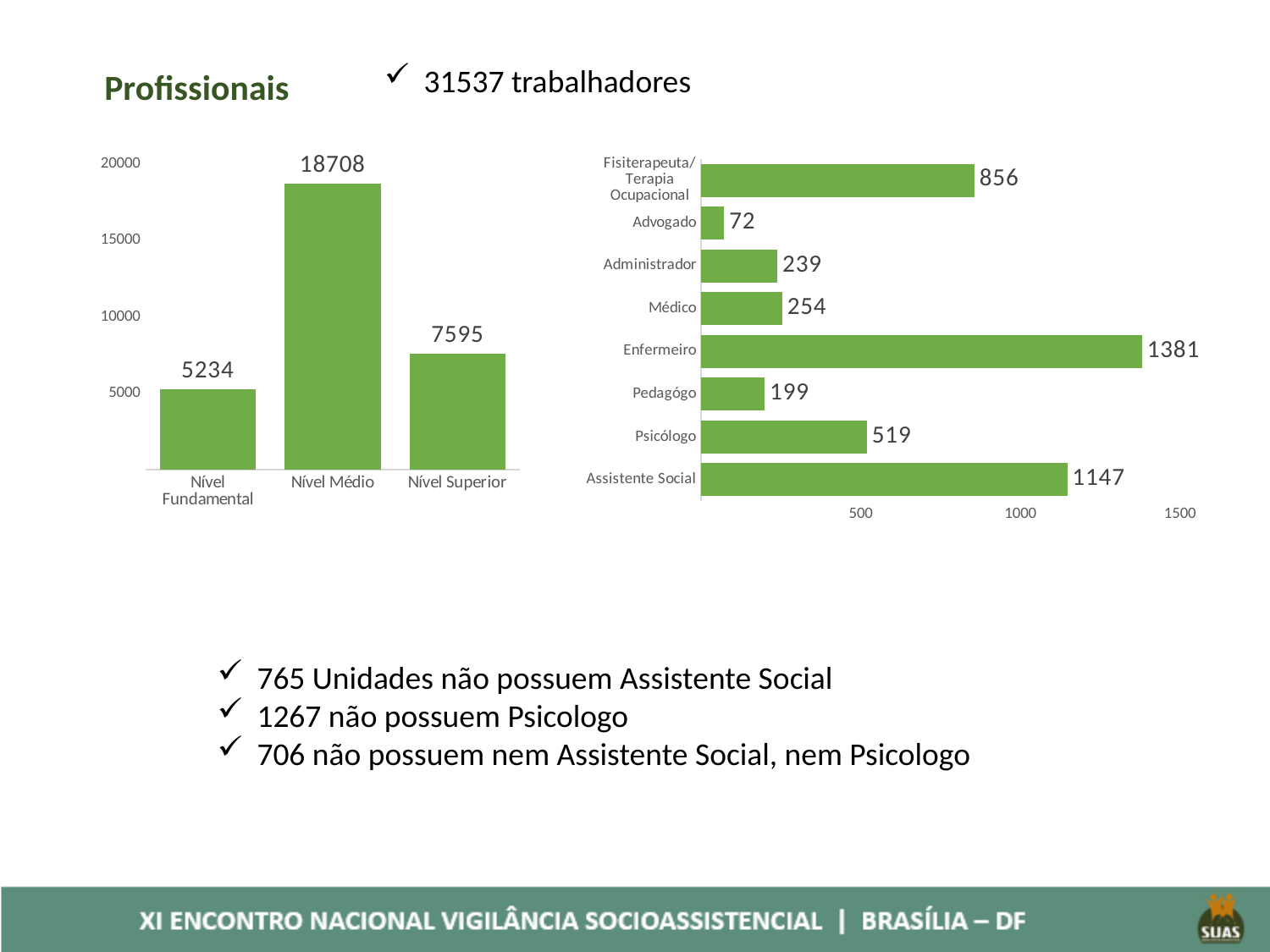
In the right chart, which is larger, Médico or Administrador? Médico In the left chart, how many categories are shown? 3 In the right chart, is the value for Fisiterapeuta/Terapia Ocupacional greater or less than 1000? less In the right chart, what is the value for Psicólogo? 519 In the right chart, what is the difference between Enfermeiro and Assistente Social? 234 In the right chart, which category has the highest value? Enfermeiro What kind of chart is the chart on the right? Bar chart In the left chart, which category has the lowest value? Nível Fundamental In the left chart, what is the value for Nível Médio? 18708 In the left chart, what is the difference between Nível Superior and Nível Fundamental? 2361 In the right chart, which category has the lowest value? Advogado In the right chart, how many categories are shown? 8